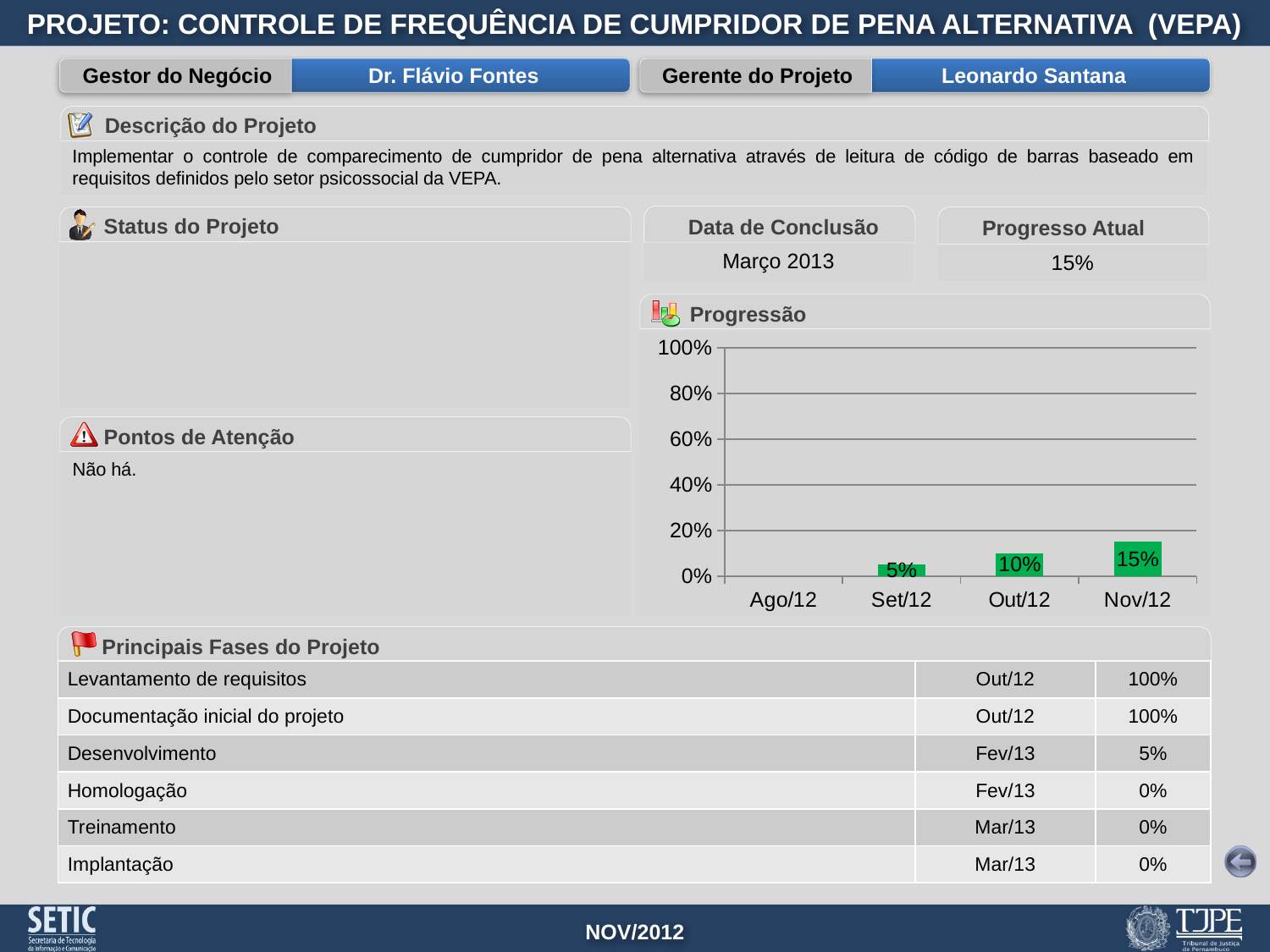
In the Progressão chart, what is the value for Set/12? 5% In the Progressão chart, do the values rise or fall from Set/12 to Nov/12? rise What kind of chart is the Progressão chart? bar chart In the Progressão chart, is the value for Nov/12 greater or less than 20%? less In the Progressão chart, what is the difference between the values for Nov/12 and Set/12? 10% In the Progressão chart, which month has the highest value? Nov/12 How many months are shown on the x axis of the Progressão chart? 4 In the Progressão chart, what is the difference between the values for Out/12 and Set/12? 5% In the Progressão chart, which is larger, the value for Out/12 or the value for Set/12? Out/12 What is the title of the chart on the slide? Progressão In the Progressão chart, what is the value for Out/12? 10% In the Progressão chart, what is the value for Nov/12? 15%